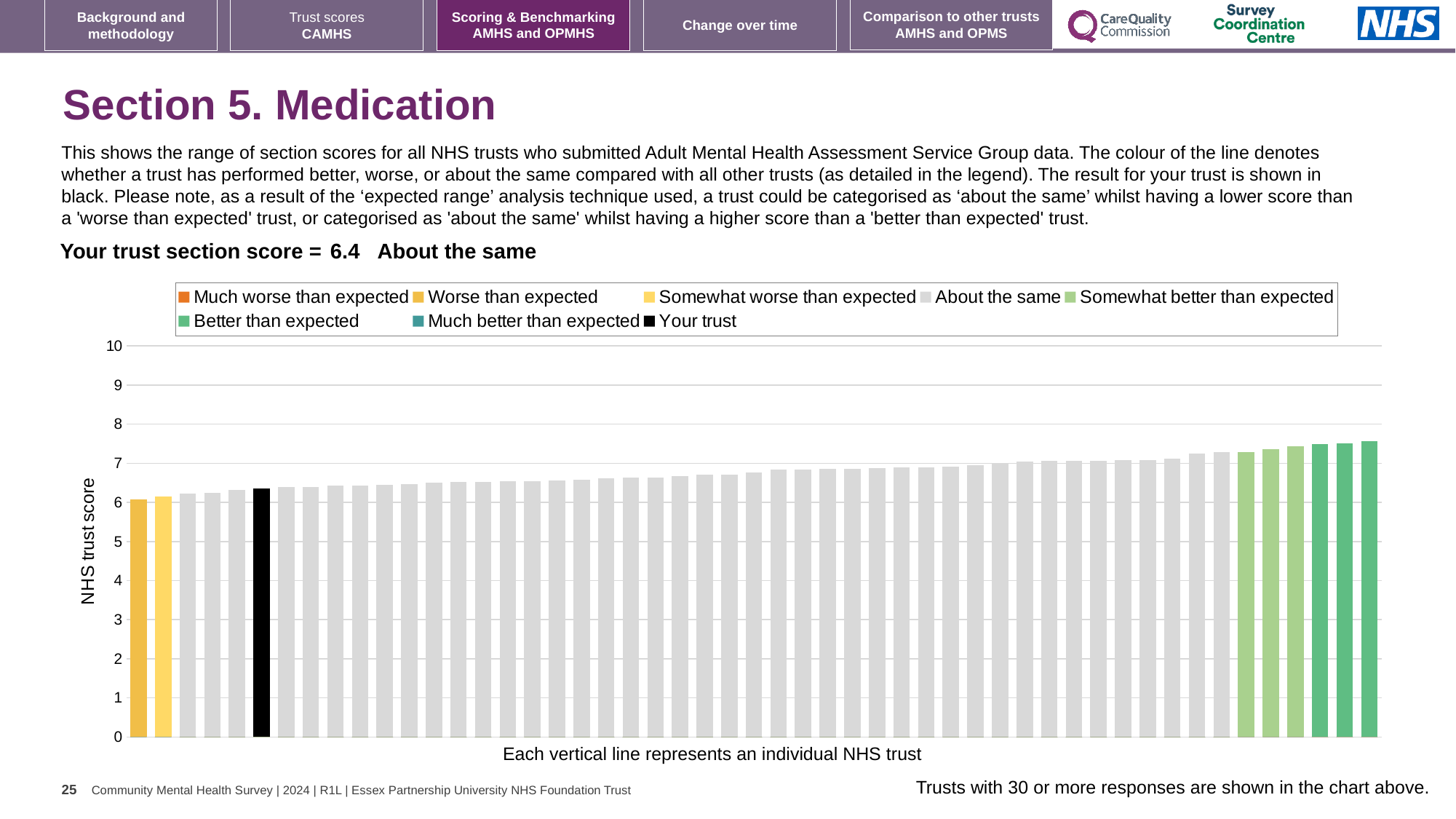
Is the value of the shortest bar in the chart greater or less than 5? greater Which category is your trust placed in for this section? About the same Which is larger, the leftmost bar or the rightmost bar? the rightmost bar Is the value of the black bar (your trust) greater or less than 5? greater According to the legend, what colour represents 'Your trust'? black Do the bar values rise or fall from left to right across the chart? rise Is the value of the tallest bar in the chart greater or less than 8? less What kind of chart is shown on the slide? bar chart What is the label on the vertical axis of the chart? NHS trust score What is the section score for your trust shown on the slide? 6.4 How many entries does the chart legend list? 8